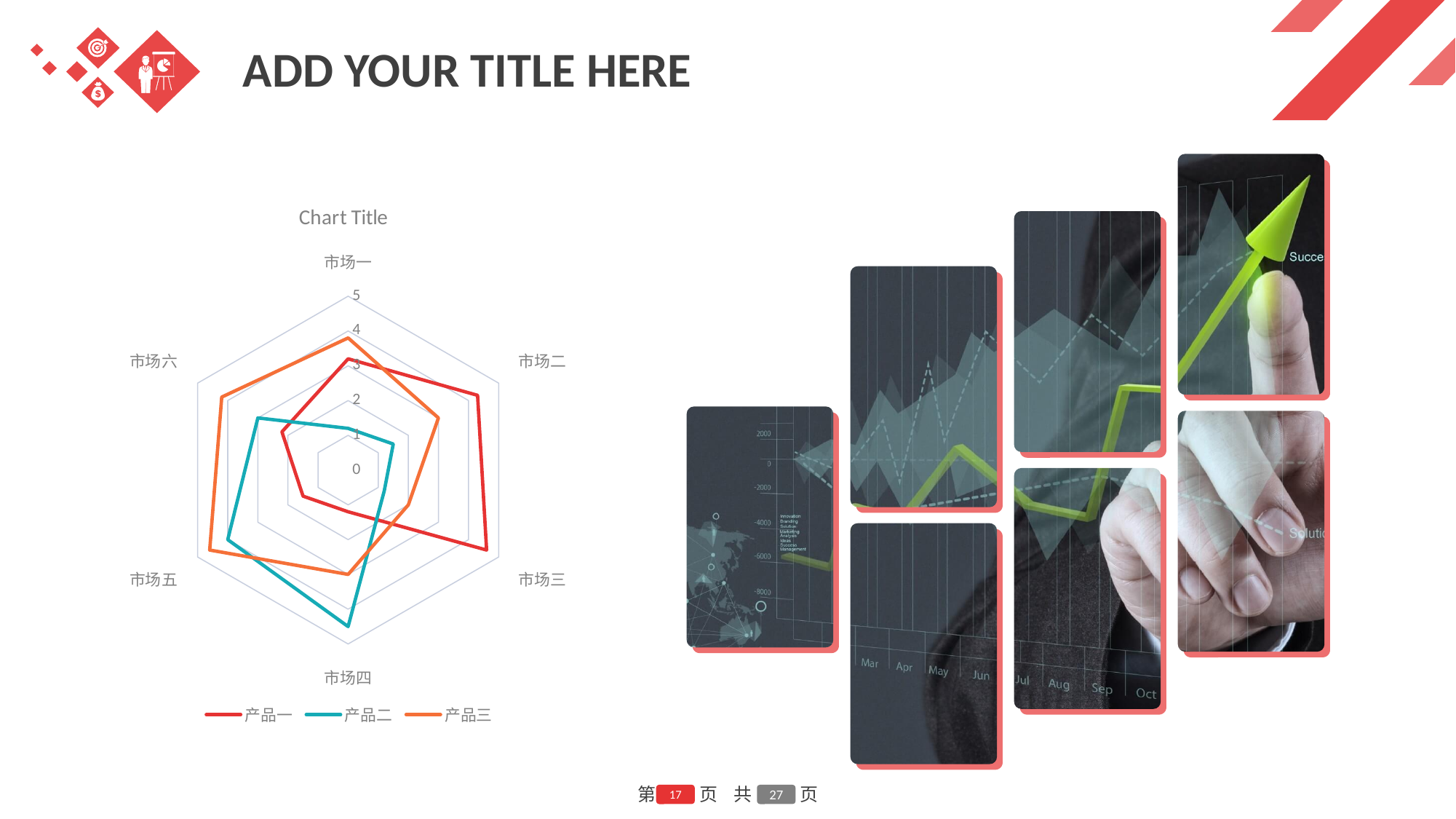
For 市场三, which series has the larger value, 产品一 or 产品二? 产品一 Is the value of 产品三 for 市场五 greater or less than 4? greater Which series are listed in the chart legend? 产品一, 产品二, 产品三 What kind of chart is shown on the slide? Radar chart How many categories (axes) does the radar chart have? 6 Is the value of 产品二 for 市场一 greater or less than 2? less What is the title of the chart? Chart Title Is the value of 产品一 for 市场四 greater or less than 2? less For 市场一, which series has the larger value, 产品二 or 产品三? 产品三 How many series does the chart legend list? 3